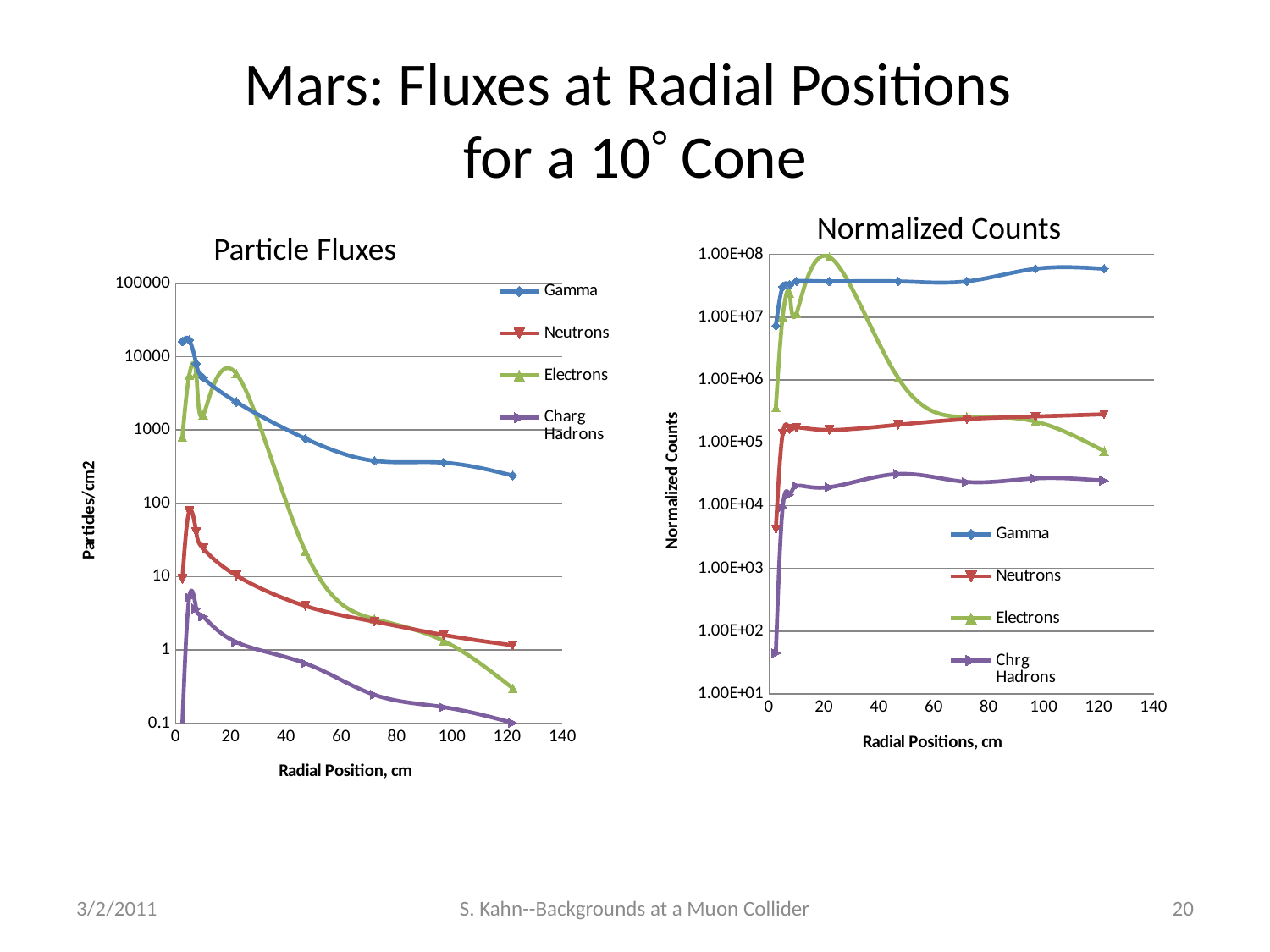
What kind of chart is the "Particle Fluxes" chart on the left? line chart How many series does the legend of the "Normalized Counts" chart list? 4 In the "Normalized Counts" chart, is the Electrons value at about 120 cm greater or less than 1.00E+05? less In the "Normalized Counts" chart, what is the label of the x axis? Radial Positions, cm In the "Normalized Counts" chart, which series has the lowest value at about 120 cm? Chrg Hadrons In the "Particle Fluxes" chart, is the Electrons value at about 120 cm greater or less than 1? less In the "Particle Fluxes" chart, does the Gamma series rise or fall from about 20 cm to 120 cm? fall In the "Particle Fluxes" chart, is the Charg Hadrons value at about 72 cm greater or less than 1? less In the "Particle Fluxes" chart, what is the label of the y axis? Particles/cm2 In the "Particle Fluxes" chart, which series has the highest value at about 120 cm? Gamma